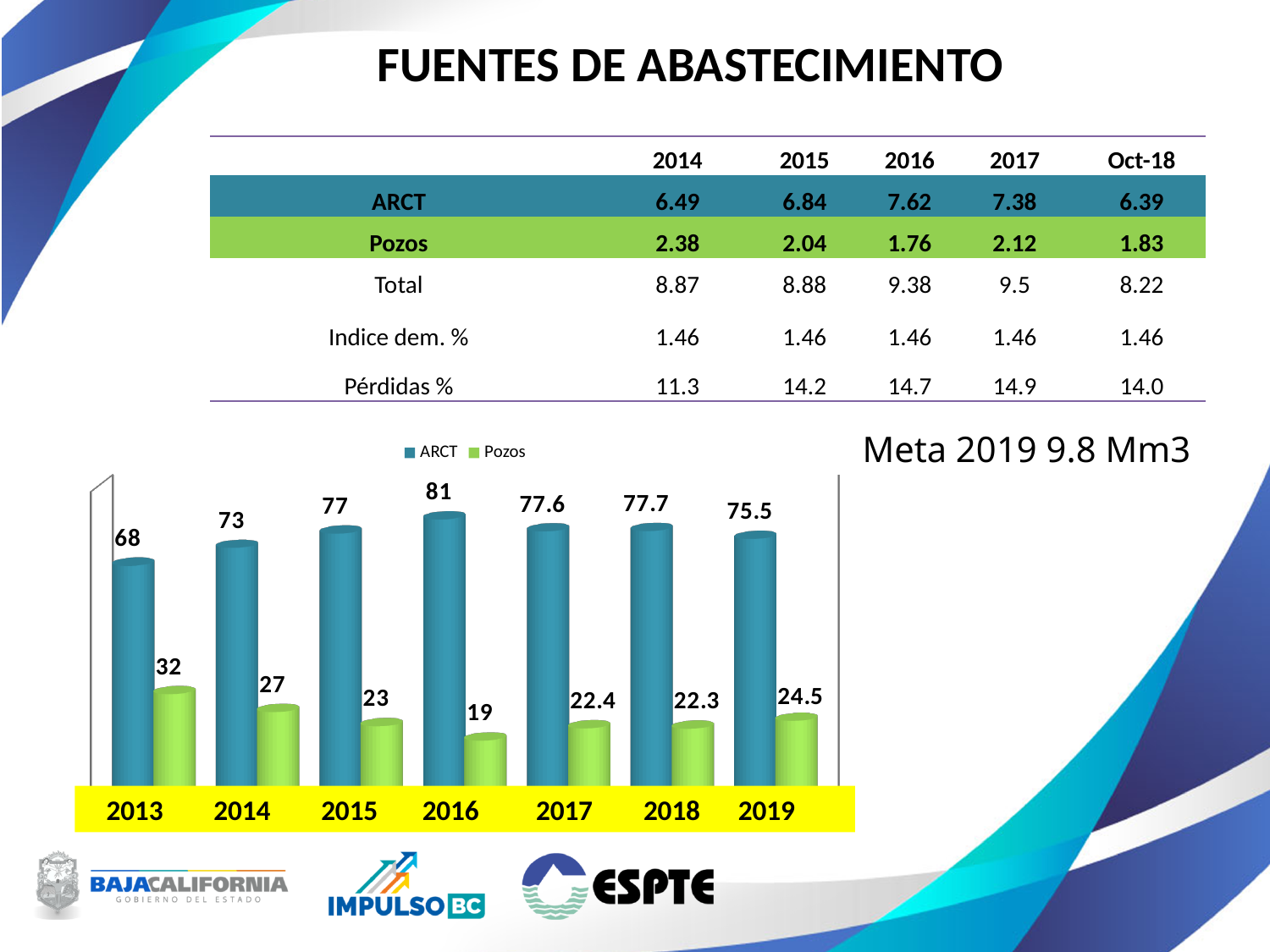
In which year is the ARCT value highest in the bar chart? 2016 What type of chart is shown on the slide? bar chart What is the Pozos value for 2019 in the bar chart? 24.5 In which year is the ARCT value lowest in the bar chart? 2013 What is the ARCT value for 2018 in the bar chart? 77.7 What is the Pozos value for 2013 in the bar chart? 32 In which year is the Pozos value lowest in the bar chart? 2016 What is the ARCT value for 2016 in the bar chart? 81 What is the difference between the ARCT value for 2016 and the ARCT value for 2013 in the bar chart? 13 How many years are shown on the x axis of the bar chart? 7 Which is larger in the bar chart: the Pozos value for 2014 or the Pozos value for 2015? 2014 How many series does the legend of the bar chart list? 2